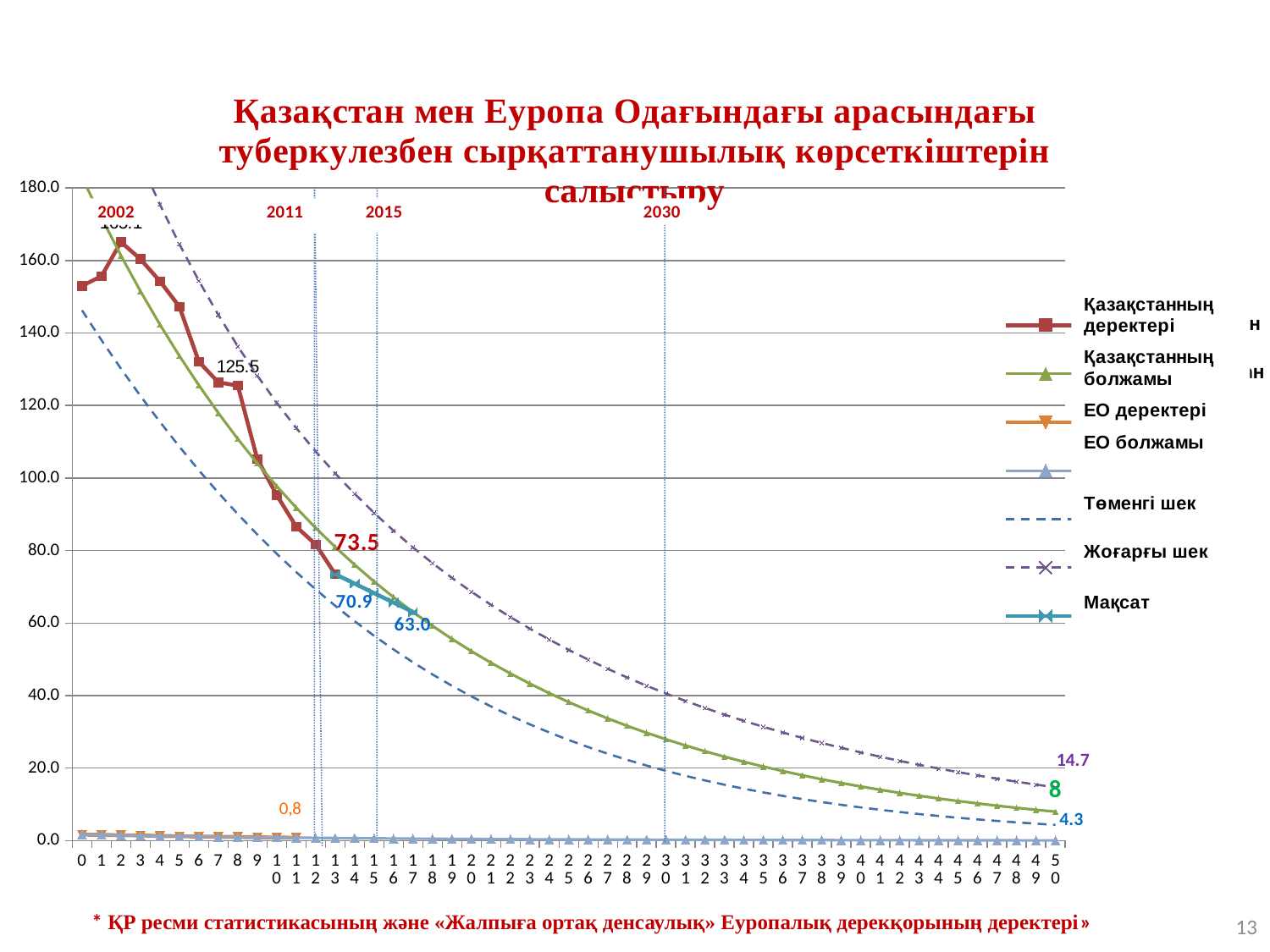
What is the maximum value shown on the vertical axis? 180.0 What is the final labelled value of the Төменгі шек series at the right end of the chart? 4.3 What kind of chart is shown on the slide? line chart Does the Қазақстанның болжамы series rise or fall along the x axis? fall Is the value of Қазақстанның деректері at point 0 greater or less than 140? greater What value is labelled on the Қазақстанның деректері series at point 8? 125.5 At the right end of the chart, which is larger: Жоғарғы шек or Төменгі шек? Жоғарғы шек What is the difference between the end values of Жоғарғы шек (14.7) and Төменгі шек (4.3)? 10.4 What is the labelled value of the Мақсат series at its right end (around point 17)? 63.0 How many series does the legend list? 7 What is the final labelled value of the Жоғарғы шек series at the right end of the chart? 14.7 What is the final labelled value of the Қазақстанның болжамы series at the right end of the chart? 8